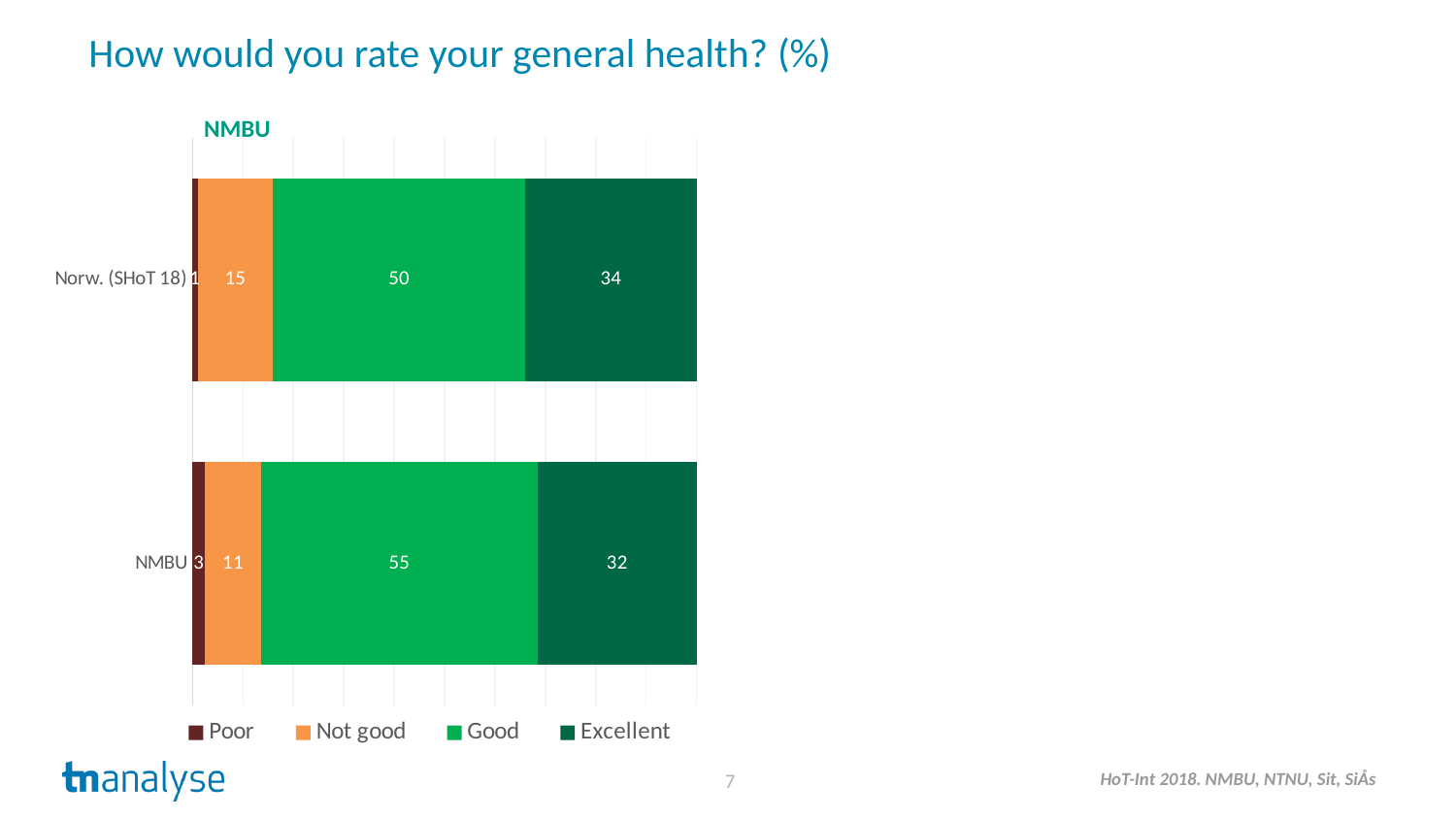
Which rating category has the lowest value in the Norw. (SHoT 18) bar? Poor What is the value for Excellent in the Norw. (SHoT 18) bar? 34 How many bars are shown in the chart? 2 What is the value for Poor in the Norw. (SHoT 18) bar? 1 What is the total of the Norw. (SHoT 18) stacked bar? 100 Which rating category has the highest value in the NMBU bar? Good What kind of chart is shown on the slide? Stacked bar chart Which group has the larger Not good value, NMBU or Norw. (SHoT 18)? Norw. (SHoT 18) What is the difference between the Good values for NMBU and Norw. (SHoT 18)? 5 How many series does the legend list? 4 What is the value for Not good in the NMBU bar? 11 What percentage of NMBU respondents rated their general health as Good? 55